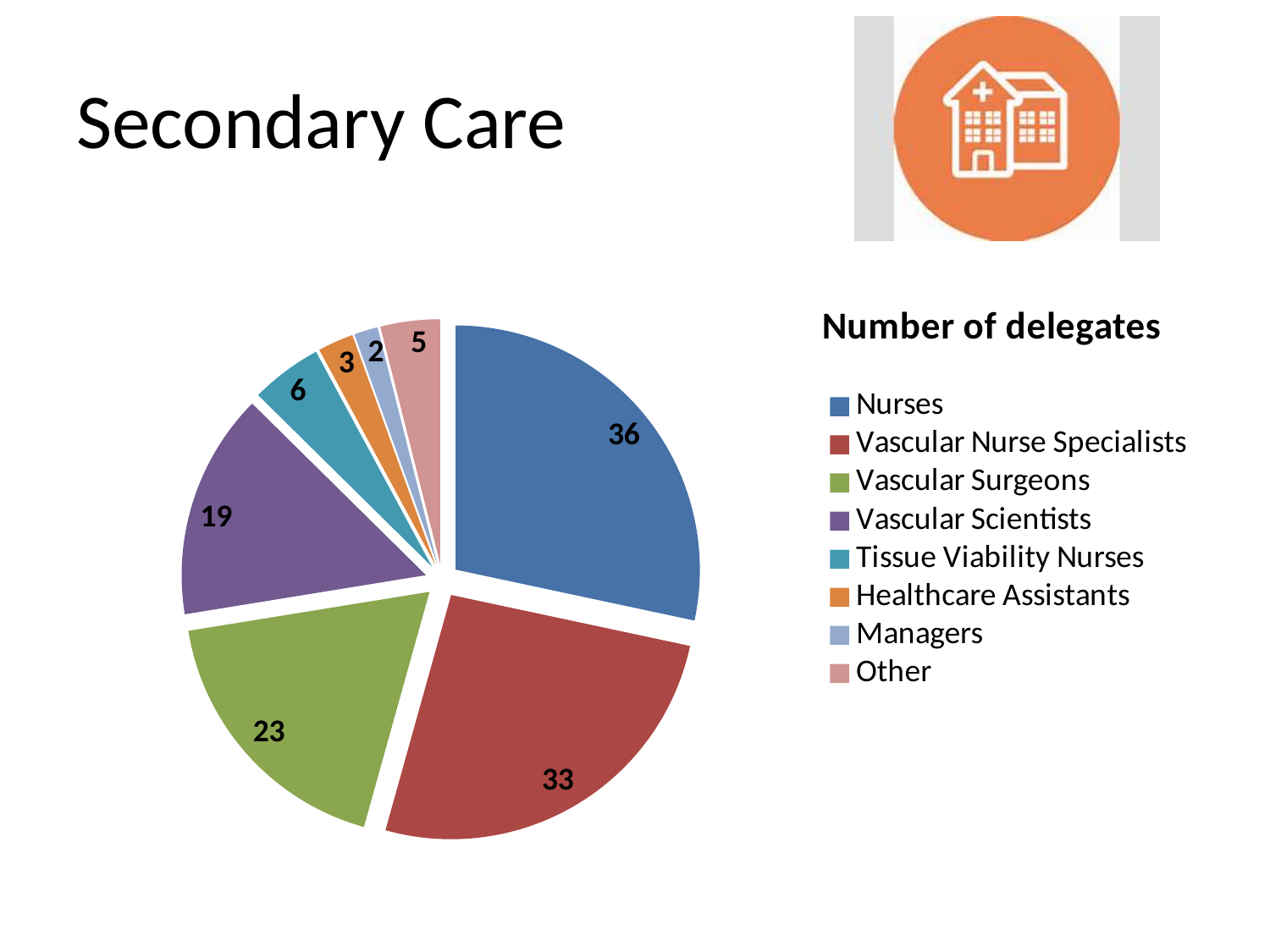
Which has more delegates, Vascular Scientists or Vascular Surgeons? Vascular Surgeons What is the difference between the number of Nurses and the number of Vascular Nurse Specialists? 3 What kind of chart is shown on the slide? Pie chart What is the total number of delegates across all categories in the pie chart? 127 Which category has the smallest number of delegates? Managers How many delegates are Nurses? 36 How many delegates are Managers? 2 What is the chart's title? Number of delegates How many delegates are Vascular Surgeons? 23 Which category has the largest number of delegates? Nurses How many categories does the pie chart show? 8 How many delegates are Tissue Viability Nurses? 6